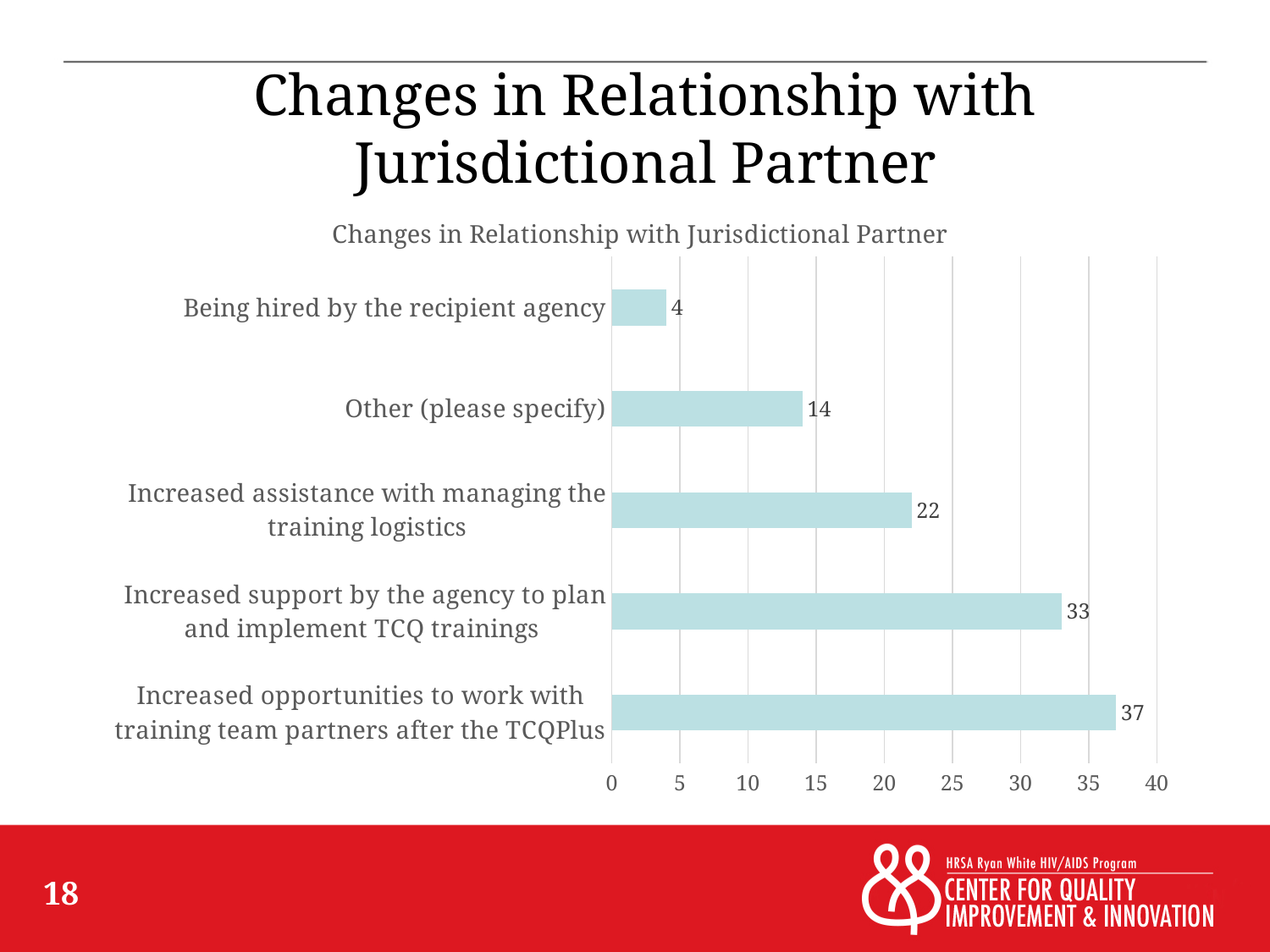
Which category has the lowest value? Being hired by the recipient agency What is the value for "Being hired by the recipient agency"? 4 What is the value for "Other (please specify)"? 14 What is the value for "Increased opportunities to work with training team partners after the TCQPlus"? 37 Is the value for "Increased support by the agency to plan and implement TCQ trainings" greater or less than 30? greater What is the value for "Increased assistance with managing the training logistics"? 22 What kind of chart is shown on the slide? Bar chart Which is larger: the value for "Other (please specify)" or the value for "Being hired by the recipient agency"? Other (please specify) How many categories are shown in the chart? 5 What is the title of the chart? Changes in Relationship with Jurisdictional Partner Which category has the highest value? Increased opportunities to work with training team partners after the TCQPlus What is the difference between the values for "Increased support by the agency to plan and implement TCQ trainings" and "Increased assistance with managing the training logistics"? 11